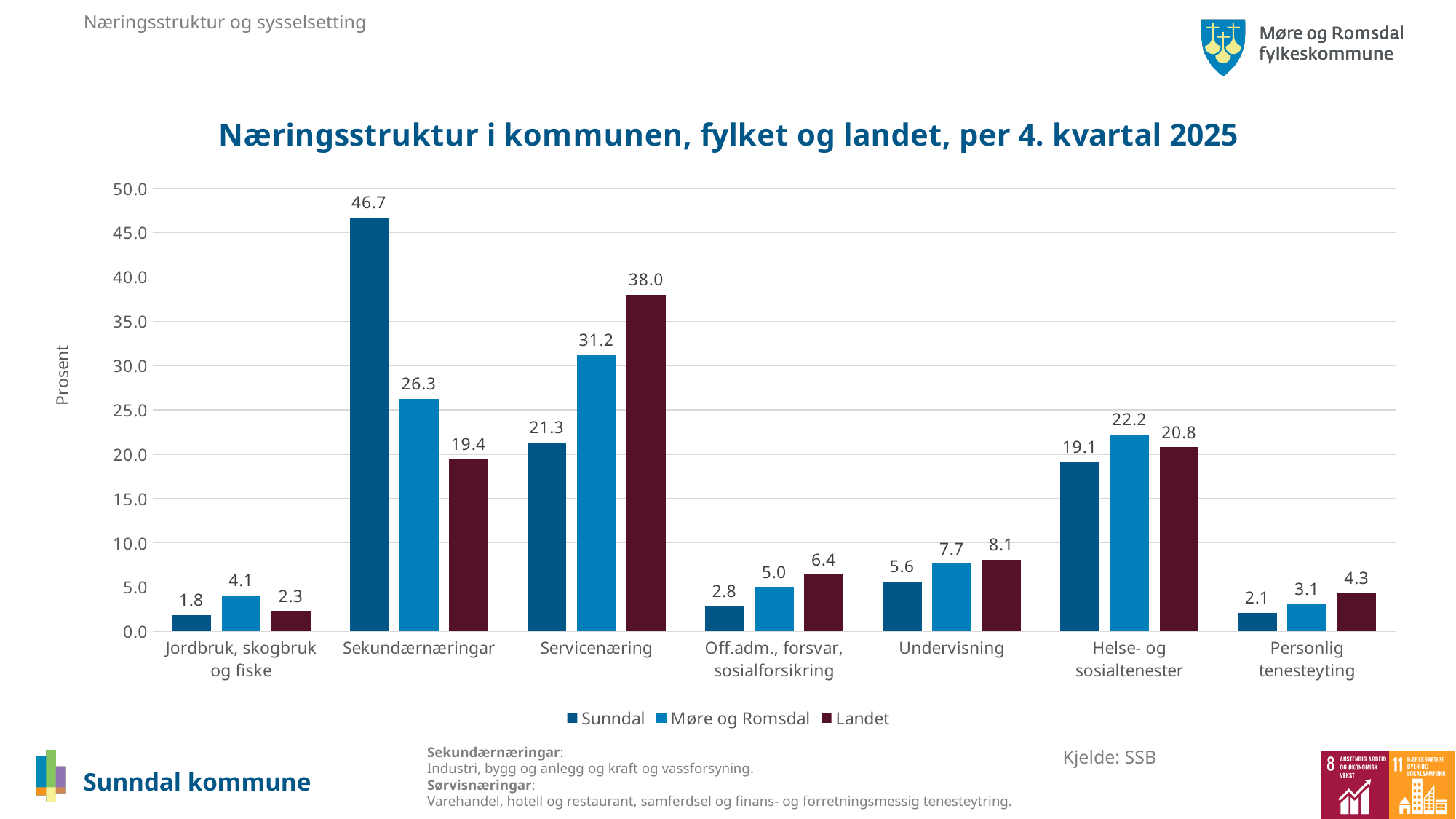
What is the value for Sunndal in Sekundærnæringar? 46.7 What is the value for Møre og Romsdal in Helse- og sosialtenester? 22.2 What kind of chart is shown on the slide? Bar chart Which category has the lowest value for Landet? Jordbruk, skogbruk og fiske Which is larger in Undervisning: the value for Sunndal or the value for Landet? Landet What is the difference between the Sunndal and Landet values in Sekundærnæringar? 27.3 What is the value for Landet in Servicenæring? 38.0 Is the value for Møre og Romsdal in Servicenæring greater or less than 30.0? greater Which category has the highest value for Sunndal? Sekundærnæringar How many categories are shown on the x axis? 7 What is the title of the chart? Næringsstruktur i kommunen, fylket og landet, per 4. kvartal 2025 How many series does the legend list? 3